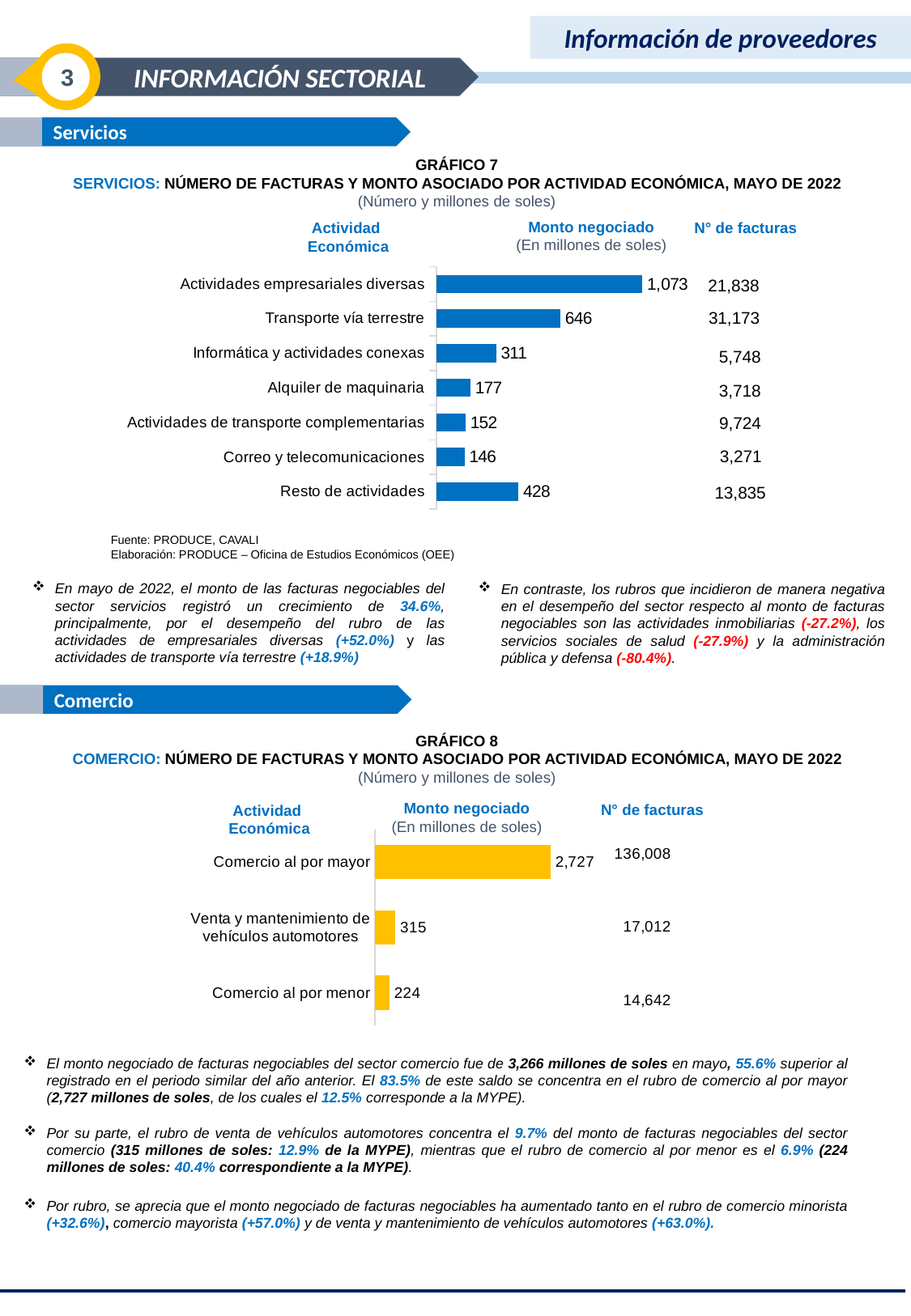
In Gráfico 7 (Servicios), how many actividades económicas are shown as bars? 7 What type of chart is Gráfico 7 (Servicios)? Bar chart In Gráfico 7 (Servicios), which actividad económica has the lowest monto negociado? Correo y telecomunicaciones In Gráfico 8 (Comercio), what is the monto negociado for Comercio al por mayor? 2,727 In Gráfico 7 (Servicios), what is the monto negociado for Transporte vía terrestre? 646 In Gráfico 7 (Servicios), which actividad económica has the highest monto negociado? Actividades empresariales diversas In Gráfico 7 (Servicios), how many facturas are listed for Actividades de transporte complementarias? 9,724 In Gráfico 8 (Comercio), what is the difference in monto negociado between Venta y mantenimiento de vehículos automotores and Comercio al por menor? 91 In Gráfico 7 (Servicios), what is the difference in monto negociado between Actividades empresariales diversas and Transporte vía terrestre? 427 In Gráfico 8 (Comercio), how many facturas are listed for Comercio al por menor? 14,642 In Gráfico 8 (Comercio), what colour are the bars? Yellow In Gráfico 7 (Servicios), which has more facturas: Transporte vía terrestre or Actividades empresariales diversas? Transporte vía terrestre